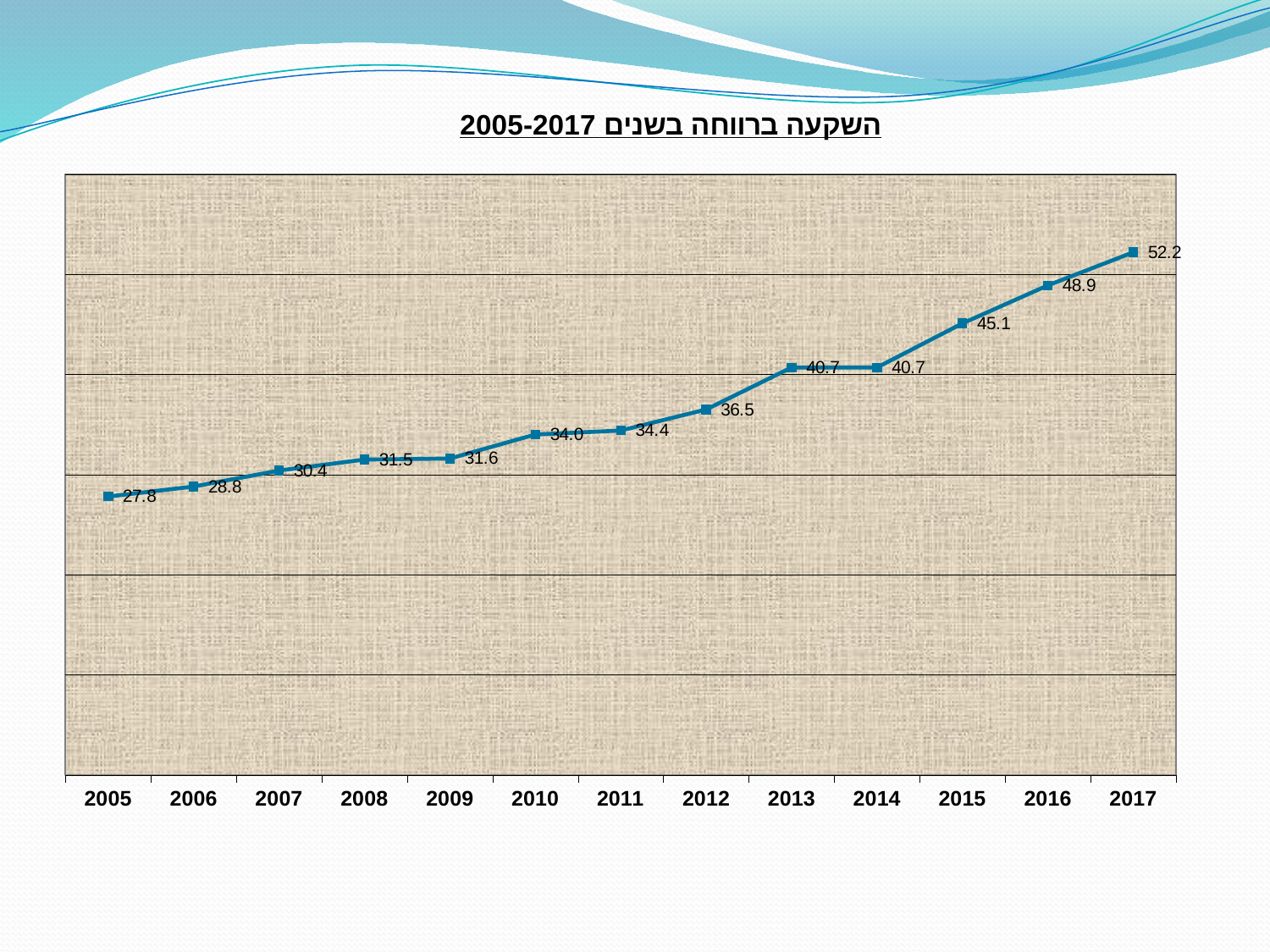
What is the value for 2010? 34.0 What is the value for 2005? 27.8 What is the value for 2017? 52.2 What is the difference between the values for 2017 and 2005? 24.4 What is the difference between the values for 2016 and 2015? 3.8 Do the values generally rise or fall from 2005 to 2017? rise Which year has the highest value? 2017 What is the value for 2013? 40.7 How many years are plotted on the x axis? 13 What type of chart is shown on the slide? line chart Which is larger, the value for 2012 or the value for 2011? 2012 Which year has the lowest value? 2005